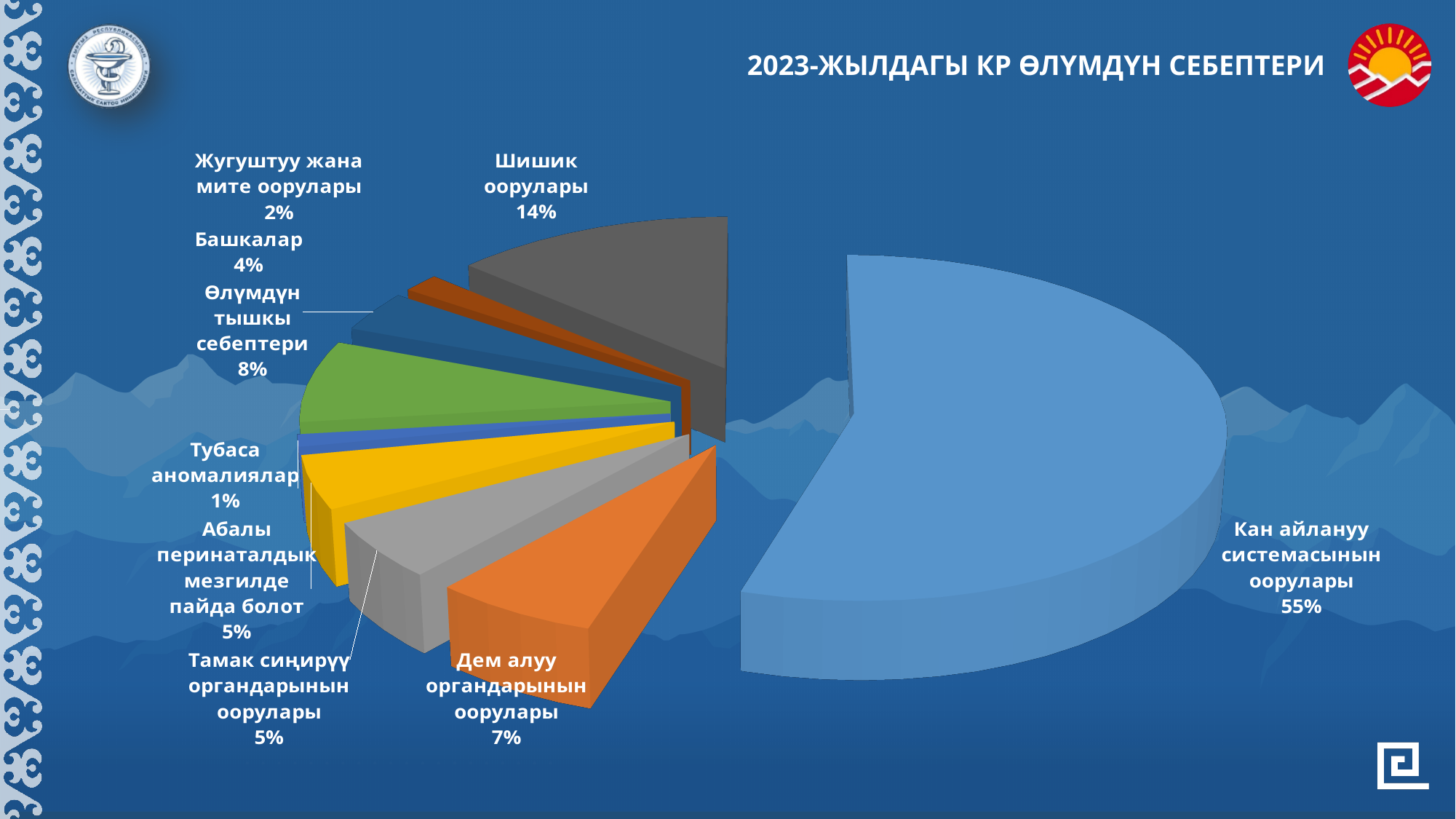
What is the title of the chart? 2023-ЖЫЛДАГЫ КР ӨЛҮМДҮН СЕБЕПТЕРИ How many slices does the pie chart have? 9 What is the value shown for "Өлүмдүн тышкы себептери"? 8% What share of the pie is labelled "Кан айлануу системасынын оорулары"? 55% What is the value shown for "Дем алуу органдарынын оорулары"? 7% Which category has the largest slice of the pie? Кан айлануу системасынын оорулары What kind of chart is shown on the slide? pie chart Which category has the smallest slice of the pie? Тубаса аномалиялар What is the value shown for "Тамак сиңирүү органдарынын оорулары"? 5% What is the value shown for "Шишик оорулары"? 14% Which is larger, the share for "Башкалар" or the share for "Жугуштуу жана мите оорулары"? Башкалар What is the difference between the shares of "Кан айлануу системасынын оорулары" and "Шишик оорулары"? 41%